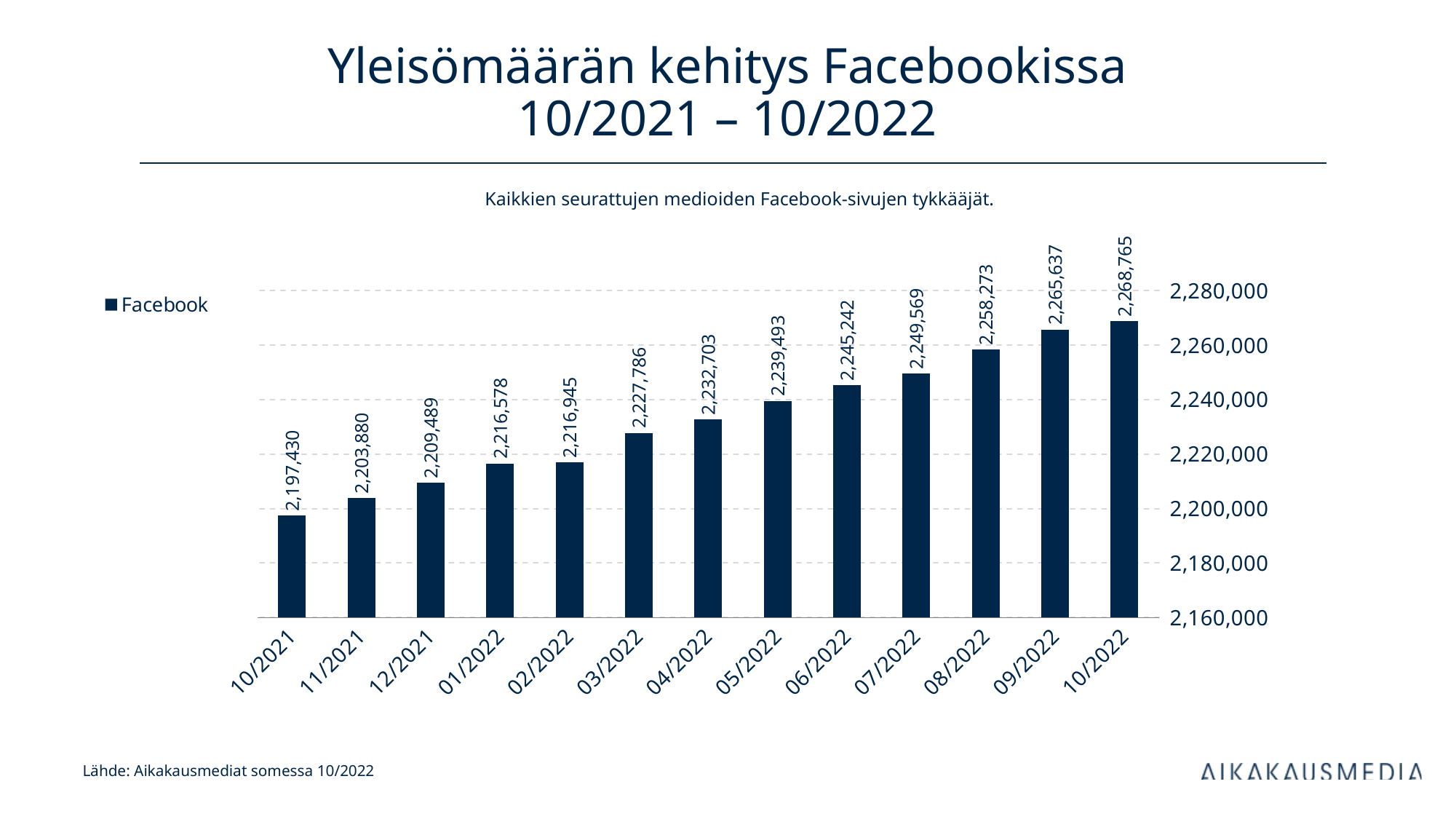
Which is larger, the value for 03/2022 or the value for 12/2021? 03/2022 Do the values rise or fall from 10/2021 to 10/2022? rise What is the value for 10/2021? 2,197,430 What is the value for 05/2022? 2,239,493 How many series does the legend list? 1 Which month has the highest value? 10/2022 Which month has the lowest value? 10/2021 What is the value for 10/2022? 2,268,765 How many months are shown on the x axis? 13 Is the value for 08/2022 greater or less than 2,240,000? greater What kind of chart is shown on the slide? bar chart What is the difference between the values for 10/2022 and 10/2021? 71,335